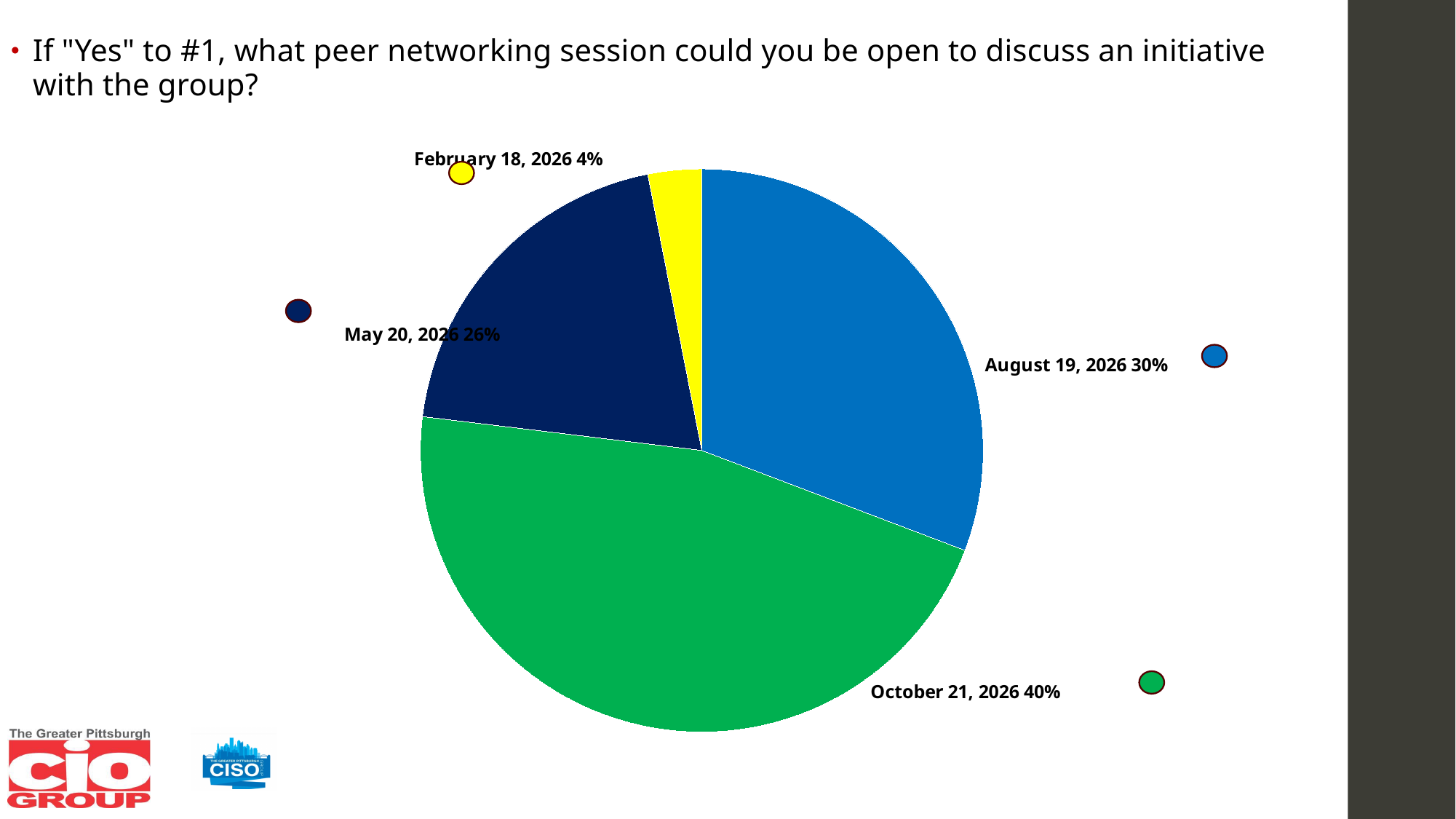
What colour is the slice for October 21, 2026? green What is the difference in percentage points between May 20, 2026 and February 18, 2026? 22 Which session has the smallest share of the pie? February 18, 2026 What share of the pie does August 19, 2026 have? 30% What share of the pie does May 20, 2026 have? 26% Which has a larger share, May 20, 2026 or August 19, 2026? August 19, 2026 What is the difference in percentage points between October 21, 2026 and August 19, 2026? 10 How many slices does the pie chart have? 4 What share of the pie does February 18, 2026 have? 4% What kind of chart is shown on the slide? pie chart Which session has the largest share of the pie? October 21, 2026